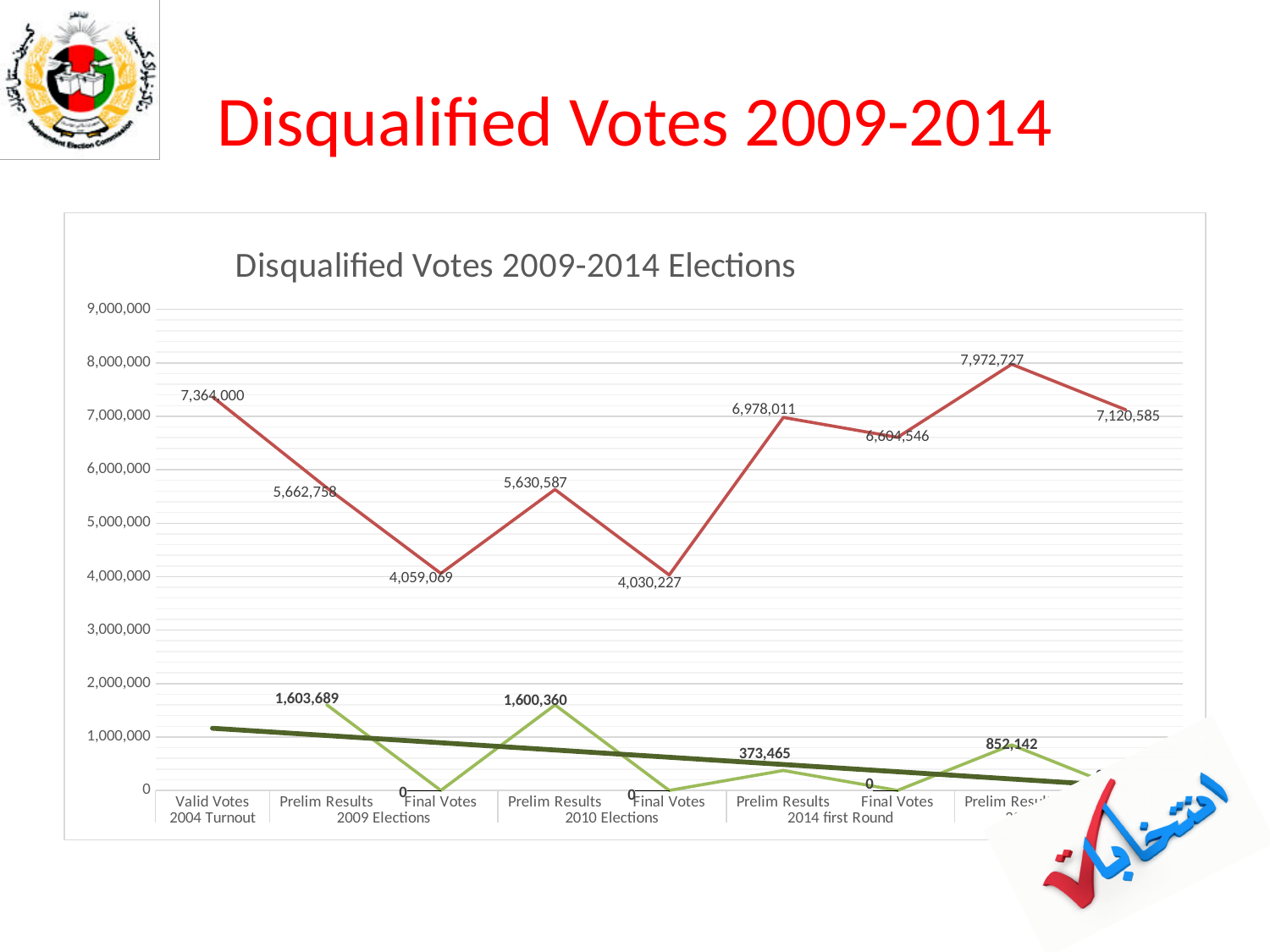
What kind of chart is shown on the slide? line chart What is the value of the green line at Prelim Results in the 2014 first Round? 373,465 Which is larger on the red line: Prelim Results or Final Votes in the 2014 first Round? Prelim Results What is the value of the green line at Prelim Results in the 2009 Elections? 1,603,689 Is the red line value at Final Votes in the 2009 Elections greater or less than 5,000,000? less What is the value of the red line at Valid Votes (2004 Turnout)? 7,364,000 What is the highest value shown on the red line? 7,972,727 Does the red line rise or fall from Prelim Results to Final Votes in the 2010 Elections? fall What is the value of the red line at Final Votes in the 2009 Elections? 4,059,069 What is the title of the chart? Disqualified Votes 2009-2014 Elections What is the difference between the red line values at Valid Votes (2004 Turnout) and Prelim Results (2009 Elections)? 1,701,242 At which category does the red line reach its lowest value? Final Votes, 2010 Elections